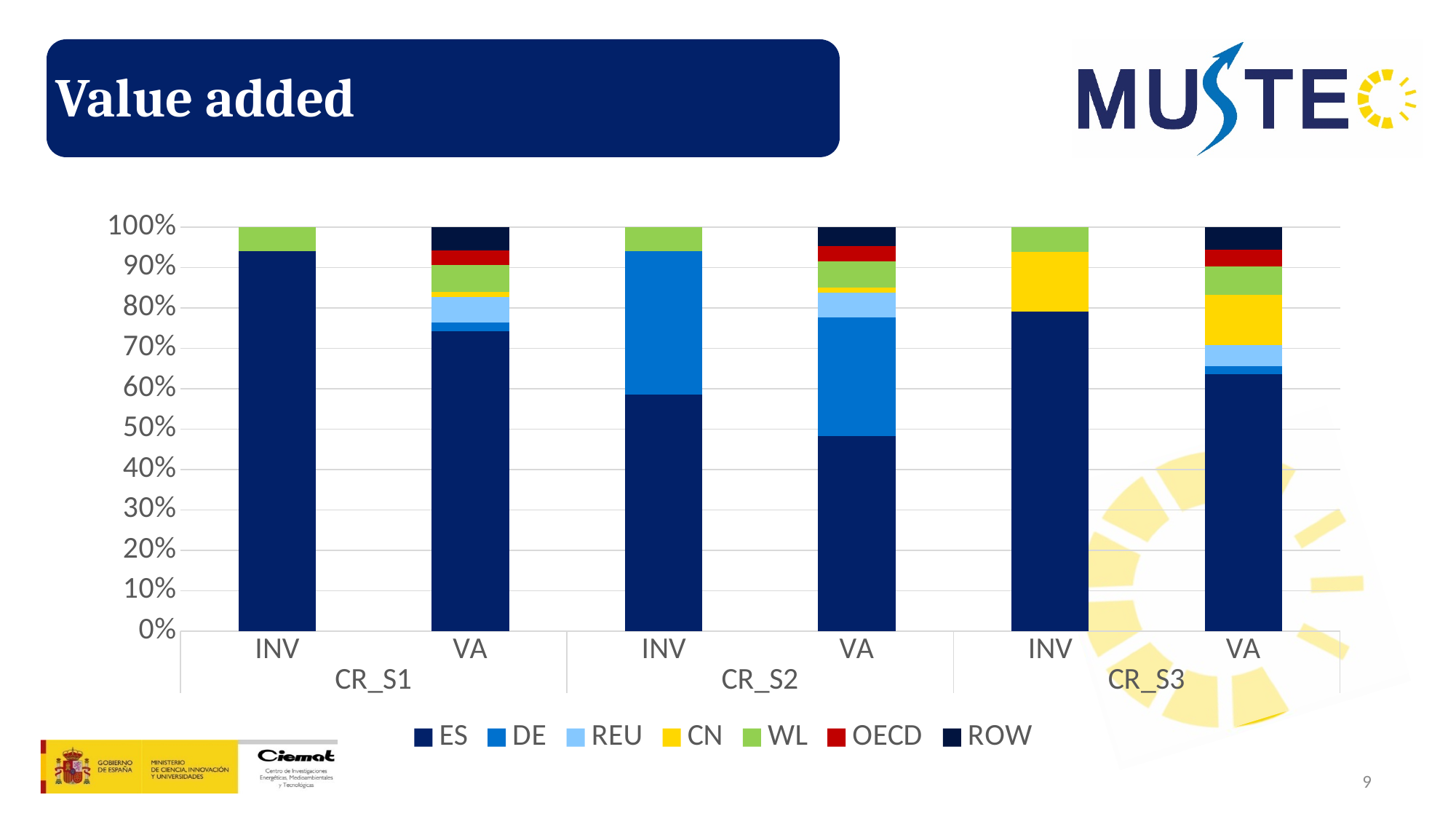
Which bar has the smallest ES share? CR_S2 VA Is the ES share of the CR_S3 VA bar greater or less than 60%? greater What is the title of the slide containing the chart? Value added Which bar has the largest ES share? CR_S1 INV How many series does the legend list? 7 Is the ES share of the CR_S1 INV bar greater or less than 90%? greater Which legend entry is shown in yellow? CN How many bars are plotted in the chart? 6 What kind of chart is shown on the slide? Stacked bar chart Is the ES share of the CR_S2 VA bar greater or less than 50%? less Which bar has the larger DE share, CR_S2 INV or CR_S3 INV? CR_S2 INV